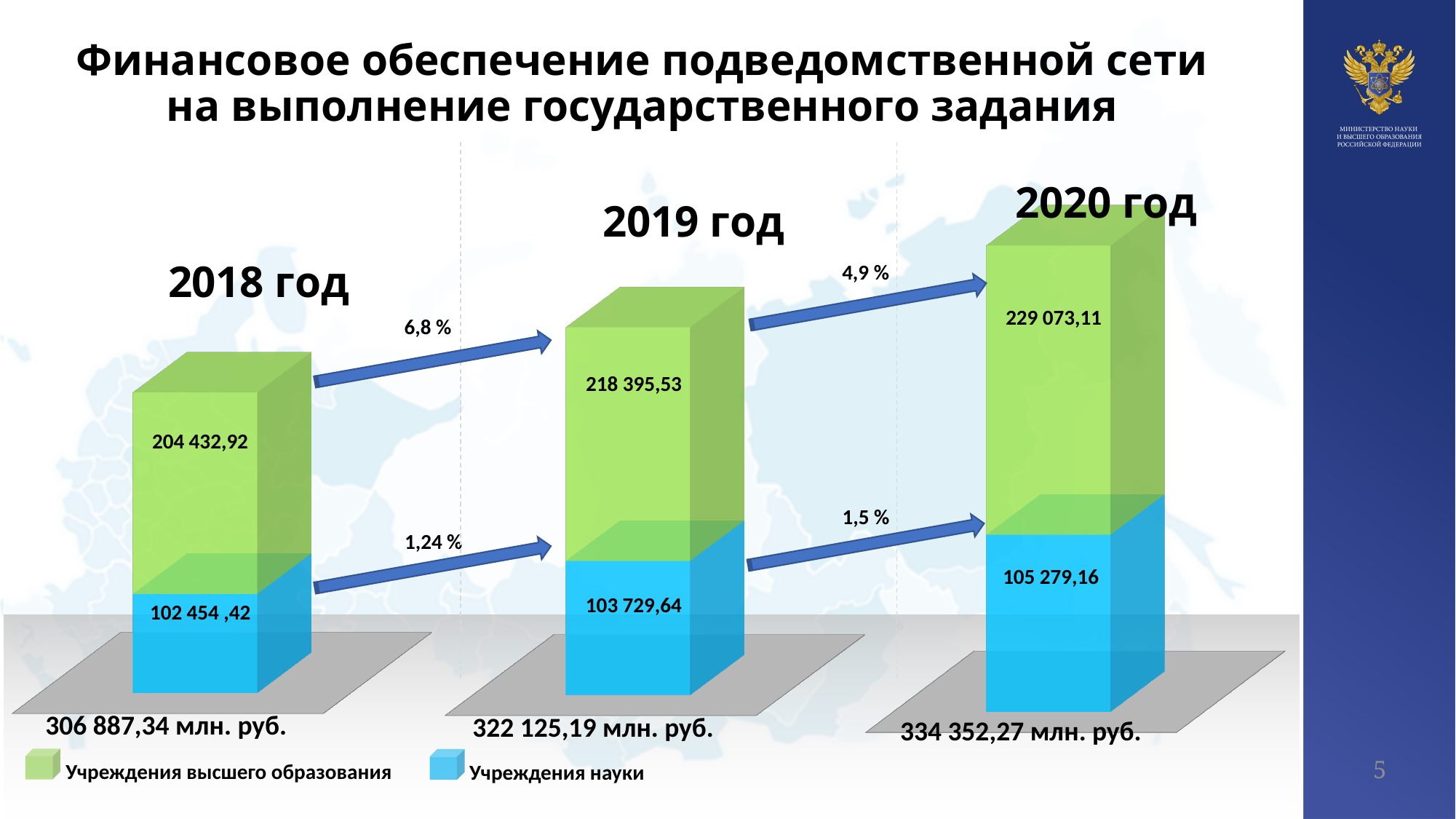
What is the difference between the Учреждения высшего образования values for 2020 and 2019? 10 677,58 What is the total for the 2019 bar? 322 125,19 млн. руб. What kind of chart is shown on the slide? Stacked bar chart Which year has the highest total? 2020 год What is the difference between the Учреждения науки values for 2020 and 2019? 1 549,52 What is the value for Учреждения науки in 2020? 105 279,16 How many series does the legend list? 2 How many years are shown in the chart? 3 Which year has the lowest total? 2018 год What is the value for Учреждения высшего образования in 2019? 218 395,53 Which is larger: Учреждения высшего образования in 2019 or Учреждения науки in 2020? Учреждения высшего образования in 2019 What is the value for Учреждения высшего образования in 2018? 204 432,92